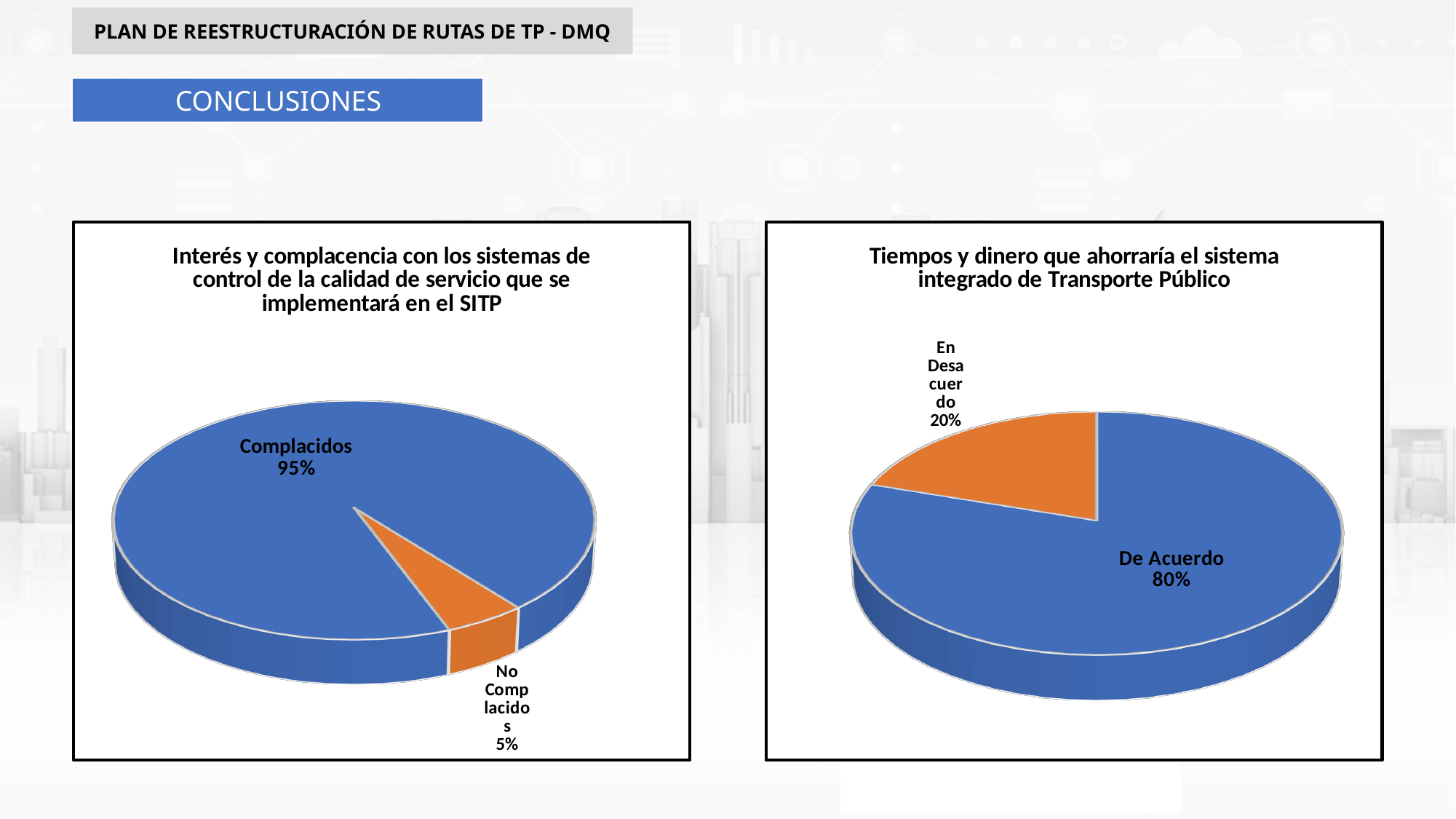
In the right chart, which is larger, De Acuerdo or En Desacuerdo? De Acuerdo In the right chart, which slice is the smallest? En Desacuerdo What kind of chart is the right chart (Tiempos y dinero que ahorraría el sistema integrado de Transporte Público)? Pie chart In the left chart (Interés y complacencia con los sistemas de control de la calidad de servicio), what share is labelled No Complacidos? 5% In the left chart, what is the difference in percentage points between Complacidos and No Complacidos? 90 percentage points In the left chart (Interés y complacencia con los sistemas de control de la calidad de servicio que se implementará en el SITP), what share is labelled Complacidos? 95% How many slices does the left chart have? 2 In the left chart, which slice is the largest? Complacidos In the right chart, what is the difference in percentage points between De Acuerdo and En Desacuerdo? 60 percentage points In the right chart (Tiempos y dinero que ahorraría el sistema integrado de Transporte Público), what share is labelled De Acuerdo? 80% In the right chart (Tiempos y dinero que ahorraría el sistema integrado de Transporte Público), what share is labelled En Desacuerdo? 20% In the right chart, what colour is the En Desacuerdo slice? Orange